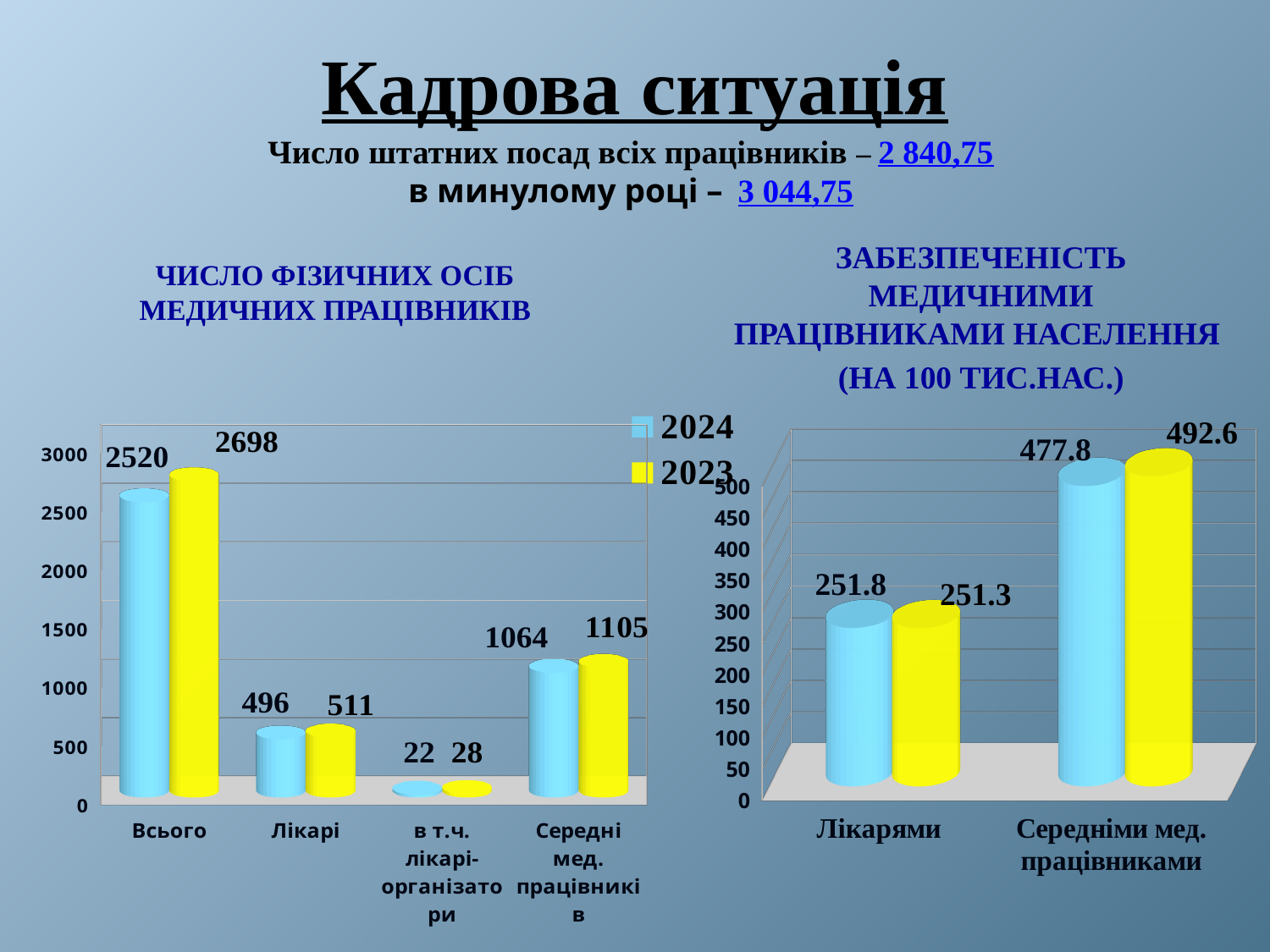
In the left chart (ЧИСЛО ФІЗИЧНИХ ОСІБ МЕДИЧНИХ ПРАЦІВНИКІВ), which category has the lowest values? в т.ч. лікарі-організатори In the left chart (ЧИСЛО ФІЗИЧНИХ ОСІБ МЕДИЧНИХ ПРАЦІВНИКІВ), what is the 2024 value for Всього? 2520 In the right chart (ЗАБЕЗПЕЧЕНІСТЬ МЕДИЧНИМИ ПРАЦІВНИКАМИ НАСЕЛЕННЯ), what is the value of the yellow bar for Середніми мед. працівниками? 492.6 In the right chart (ЗАБЕЗПЕЧЕНІСТЬ МЕДИЧНИМИ ПРАЦІВНИКАМИ НАСЕЛЕННЯ), what is the value of the blue bar for Лікарями? 251.8 In the left chart (ЧИСЛО ФІЗИЧНИХ ОСІБ МЕДИЧНИХ ПРАЦІВНИКІВ), which colour represents 2023 in the legend? Yellow In the left chart (ЧИСЛО ФІЗИЧНИХ ОСІБ МЕДИЧНИХ ПРАЦІВНИКІВ), what is the 2023 value for Лікарі? 511 In the right chart (ЗАБЕЗПЕЧЕНІСТЬ МЕДИЧНИМИ ПРАЦІВНИКАМИ НАСЕЛЕННЯ), what is the difference between the yellow and blue bars for Середніми мед. працівниками? 14.8 In the left chart (ЧИСЛО ФІЗИЧНИХ ОСІБ МЕДИЧНИХ ПРАЦІВНИКІВ), how many series does the legend list? 2 In the left chart (ЧИСЛО ФІЗИЧНИХ ОСІБ МЕДИЧНИХ ПРАЦІВНИКІВ), how many categories are shown on the x axis? 4 In the left chart (ЧИСЛО ФІЗИЧНИХ ОСІБ МЕДИЧНИХ ПРАЦІВНИКІВ), what is the difference between the 2023 and 2024 values for Всього? 178 In the left chart (ЧИСЛО ФІЗИЧНИХ ОСІБ МЕДИЧНИХ ПРАЦІВНИКІВ), what is the 2024 value for Середні мед. працівників? 1064 What kind of chart is the right chart (ЗАБЕЗПЕЧЕНІСТЬ МЕДИЧНИМИ ПРАЦІВНИКАМИ НАСЕЛЕННЯ)? Bar chart